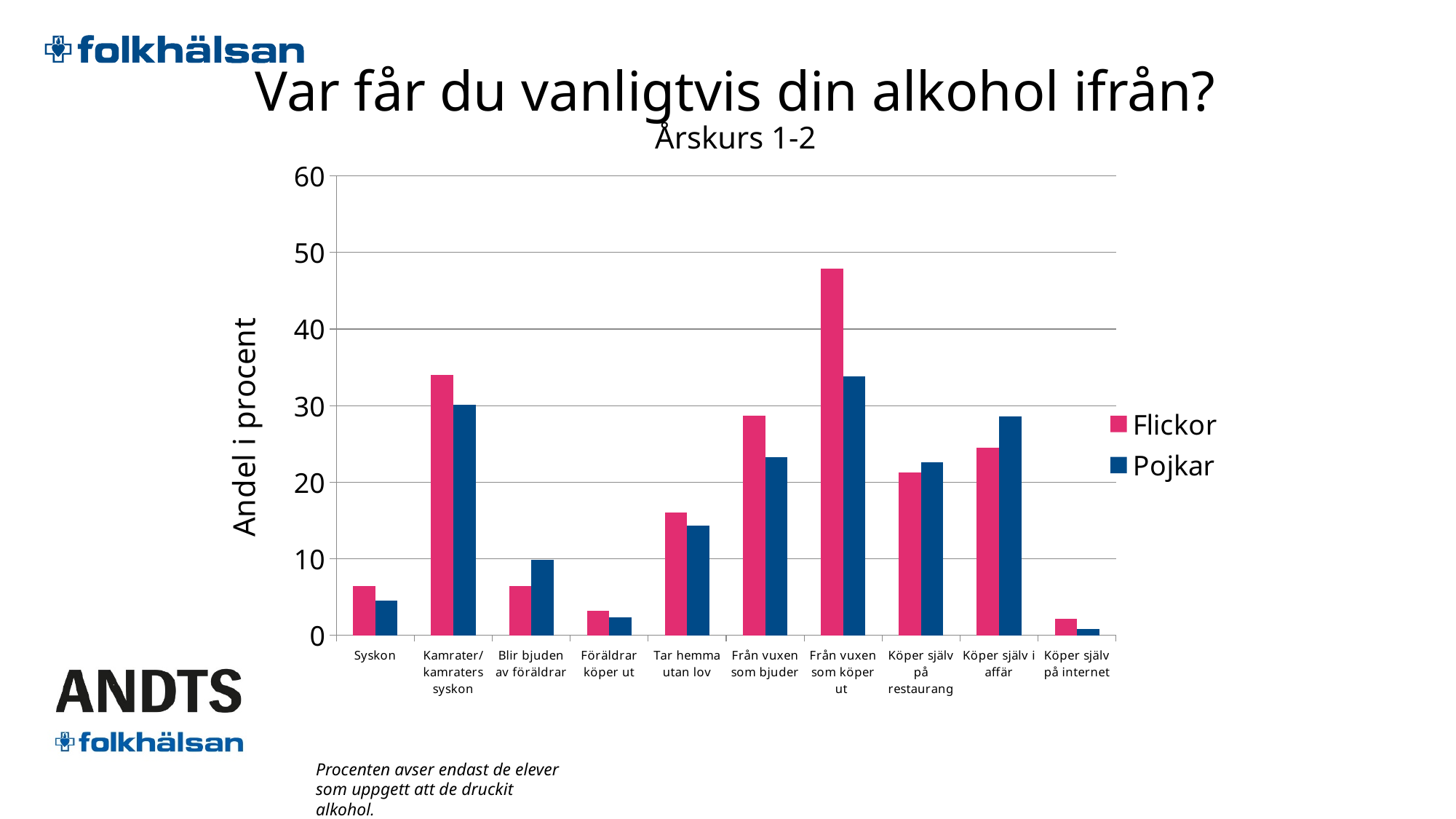
For Från vuxen som bjuder, which series has the larger value, Flickor or Pojkar? Flickor Is the value for Flickor in Tar hemma utan lov greater or less than 10? greater Which category has the lowest value for Pojkar? Köper själv på internet How many series does the legend list? 2 Which category has the highest value for Flickor? Från vuxen som köper ut For Köper själv i affär, which series has the larger value, Flickor or Pojkar? Pojkar Is the value for Flickor in Från vuxen som köper ut greater or less than 40? greater Which category has the lowest value for Flickor? Köper själv på internet What kind of chart is shown on the slide? bar chart Which category has the highest value for Pojkar? Från vuxen som köper ut How many categories are shown on the x axis? 10 Is the value for Pojkar in Köper själv i affär greater or less than 30? less